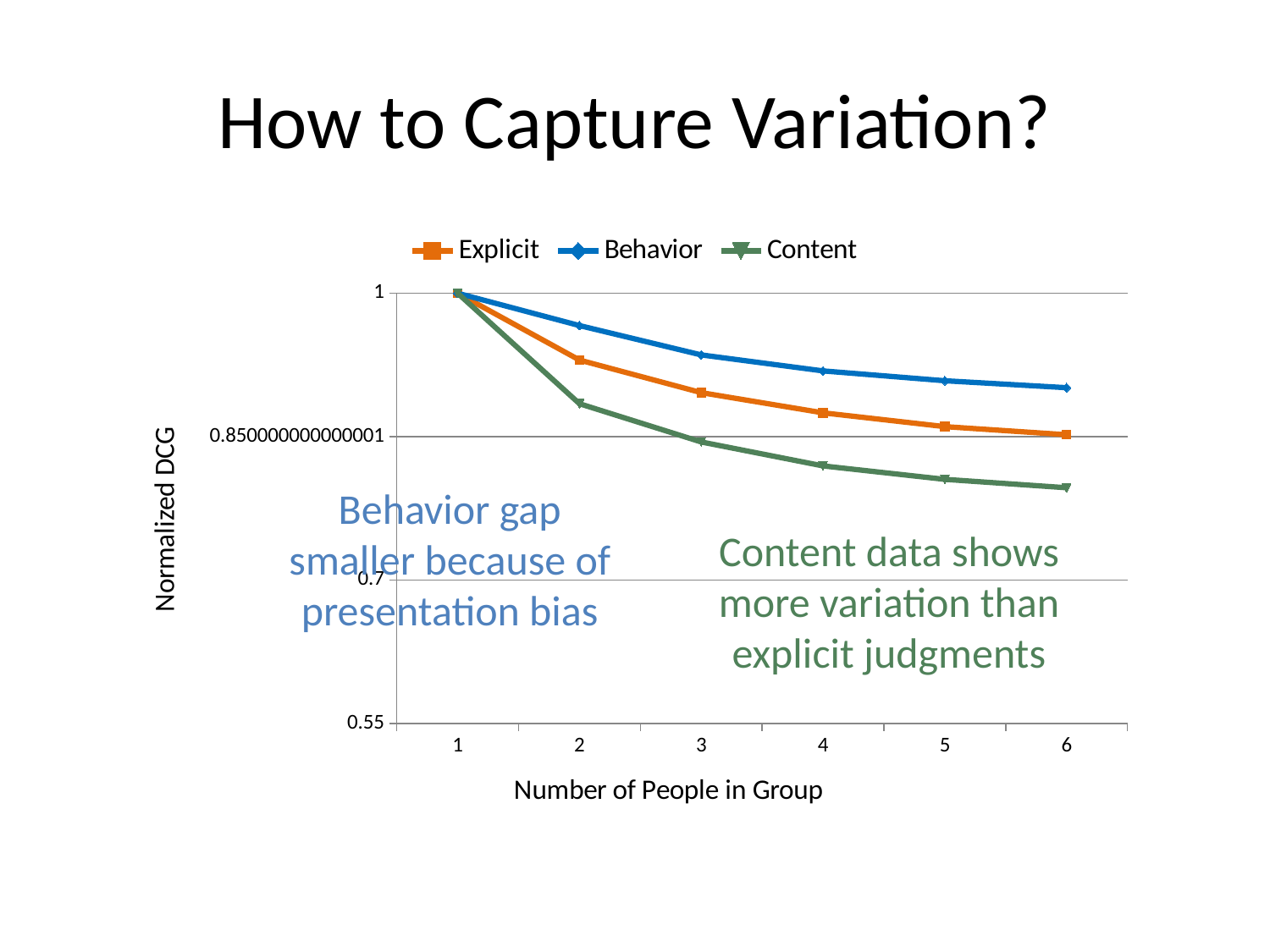
What is the Normalized DCG value for the Behavior series when the number of people in the group is 1? 1 Is the Normalized DCG for the Behavior series at 6 people greater or less than 0.85? greater Is the Normalized DCG for the Content series at 6 people greater or less than 0.85? less What kind of chart is shown on the slide? line chart Which series has the highest Normalized DCG when the number of people in the group is 6? Behavior Do the Normalized DCG values for the Explicit series rise or fall as the number of people in the group increases? fall What is the title of the x axis of the chart? Number of People in Group Is the Normalized DCG for the Content series at 2 people greater or less than 0.85? greater At 4 people in the group, which series has the larger Normalized DCG, Behavior or Content? Behavior How many series does the legend list? 3 How many points along the x axis (Number of People in Group) does each series have? 6 Which series has the lowest Normalized DCG when the number of people in the group is 6? Content